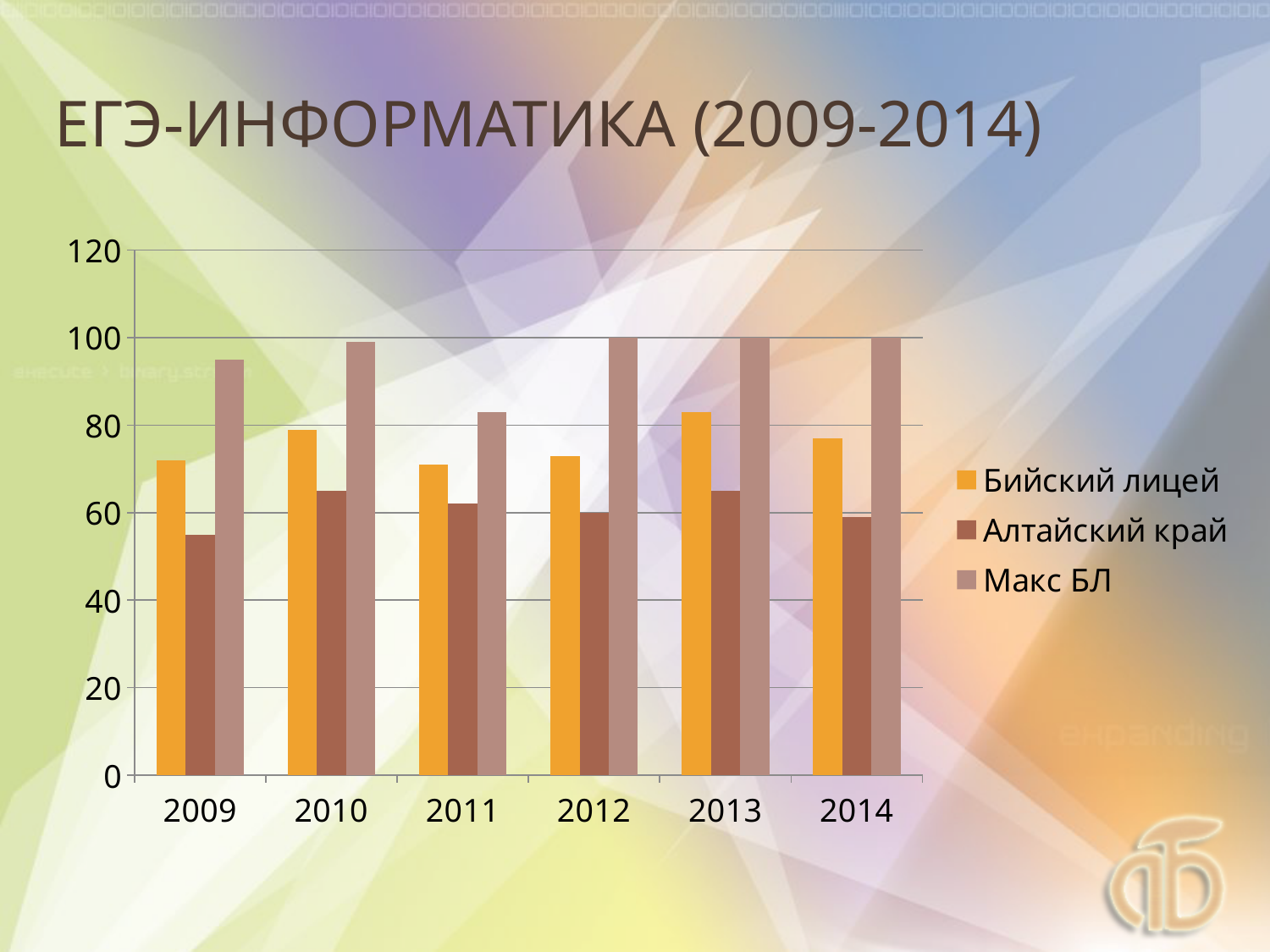
How many series does the legend list? 3 How many years are shown on the x axis? 6 Is the value for Бийский лицей in 2013 greater or less than 80? greater In 2009, which is larger: Бийский лицей or Алтайский край? Бийский лицей In which year is the value for Алтайский край the lowest? 2009 Is the value for Алтайский край in 2009 greater or less than 60? less What is the value for Макс БЛ in 2012? 100 What is the title of the slide? ЕГЭ-ИНФОРМАТИКА (2009-2014) What kind of chart is shown on the slide? bar chart Is the value for Бийский лицей in 2009 greater or less than 60? greater In which year is the value for Бийский лицей the highest? 2013